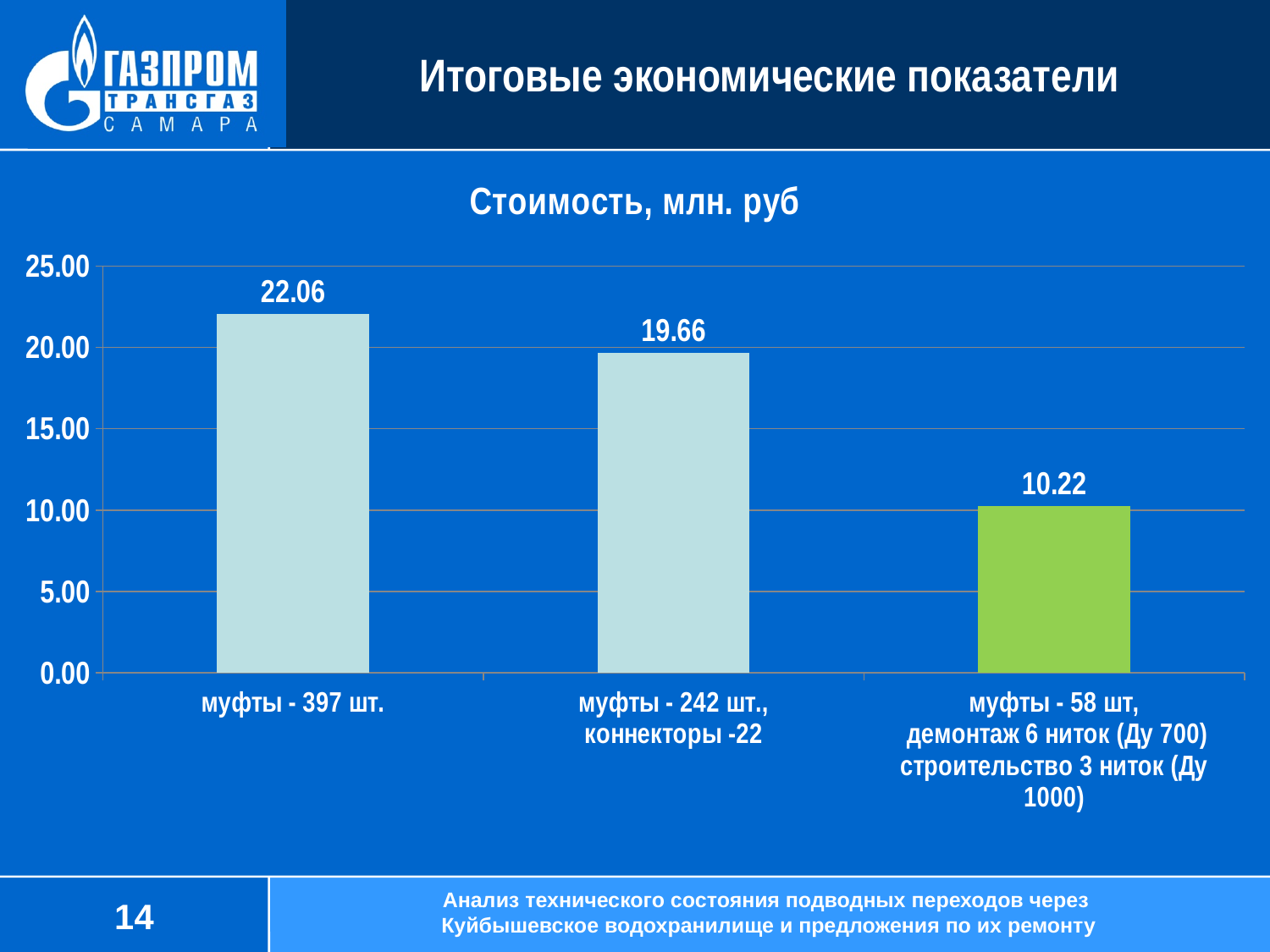
Is the value for "муфты - 242 шт., коннекторы -22" greater or less than 20.00? less What kind of chart is shown on the slide? bar chart What is the value for "муфты - 242 шт., коннекторы -22"? 19.66 Which category has the highest value? муфты - 397 шт. What is the difference between the values for "муфты - 242 шт., коннекторы -22" and "муфты - 58 шт, демонтаж 6 ниток (Ду 700) строительство 3 ниток (Ду 1000)"? 9.44 What is the title of the chart? Стоимость, млн. руб How many categories are shown in the chart? 3 Which category has the lowest value? муфты - 58 шт, демонтаж 6 ниток (Ду 700) строительство 3 ниток (Ду 1000) What is the value for "муфты - 58 шт, демонтаж 6 ниток (Ду 700) строительство 3 ниток (Ду 1000)"? 10.22 Which is larger: the value for "муфты - 397 шт." or the value for "муфты - 58 шт, демонтаж 6 ниток (Ду 700) строительство 3 ниток (Ду 1000)"? муфты - 397 шт. What is the difference between the values for "муфты - 397 шт." and "муфты - 242 шт., коннекторы -22"? 2.40 What is the value for "муфты - 397 шт."? 22.06